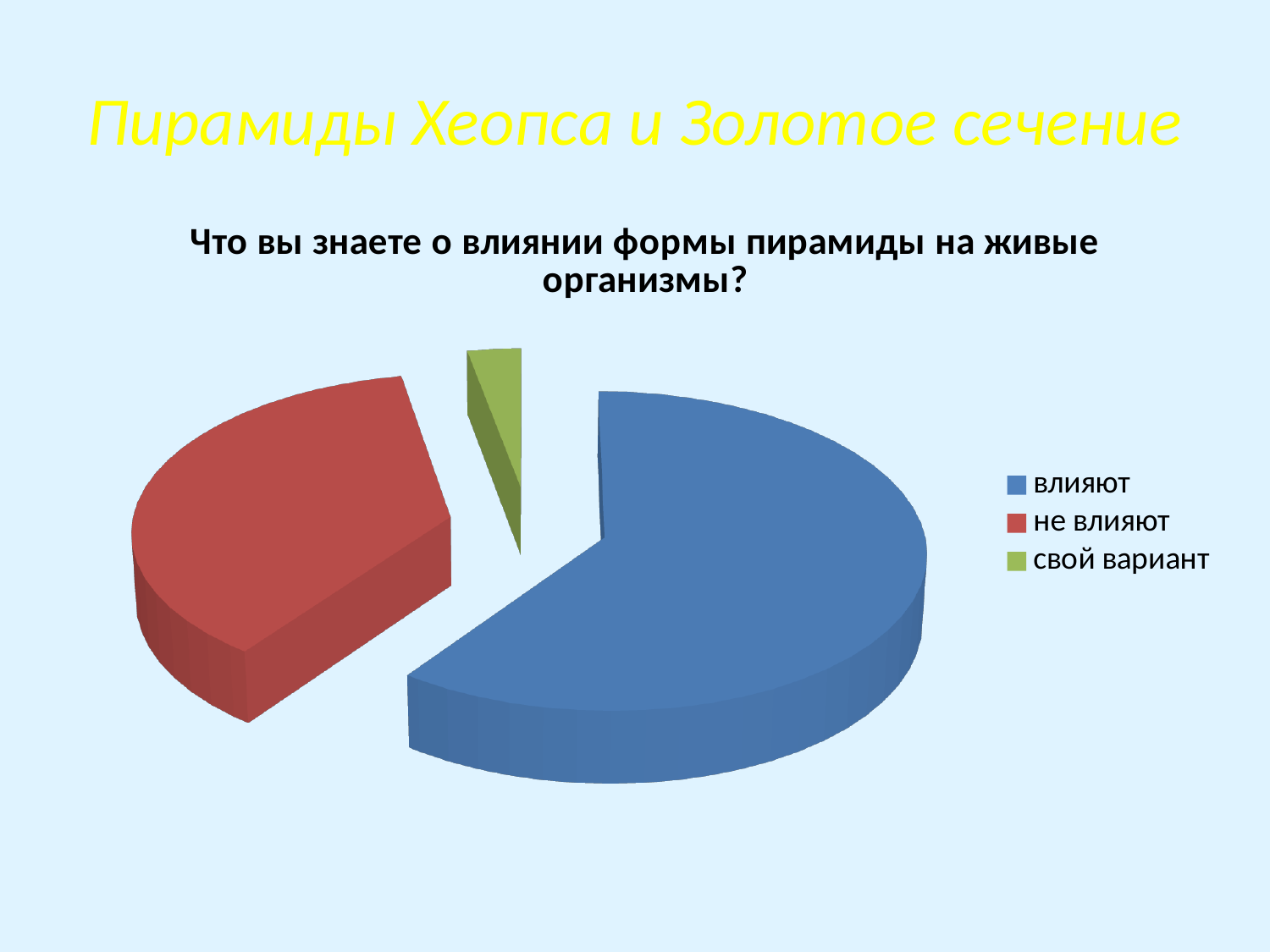
What kind of chart is shown on the slide? pie chart Which category has the largest slice of the pie chart? влияют How many entries does the legend of the pie chart list? 3 How many categories (slices) does the pie chart have? 3 Which slice is larger: "влияют" or "не влияют"? влияют What is the title of the pie chart? Что вы знаете о влиянии формы пирамиды на живые организмы? Which slice is larger: "не влияют" or "свой вариант"? не влияют Which category has the smallest slice of the pie chart? свой вариант What colour is the slice for "не влияют" in the pie chart? red